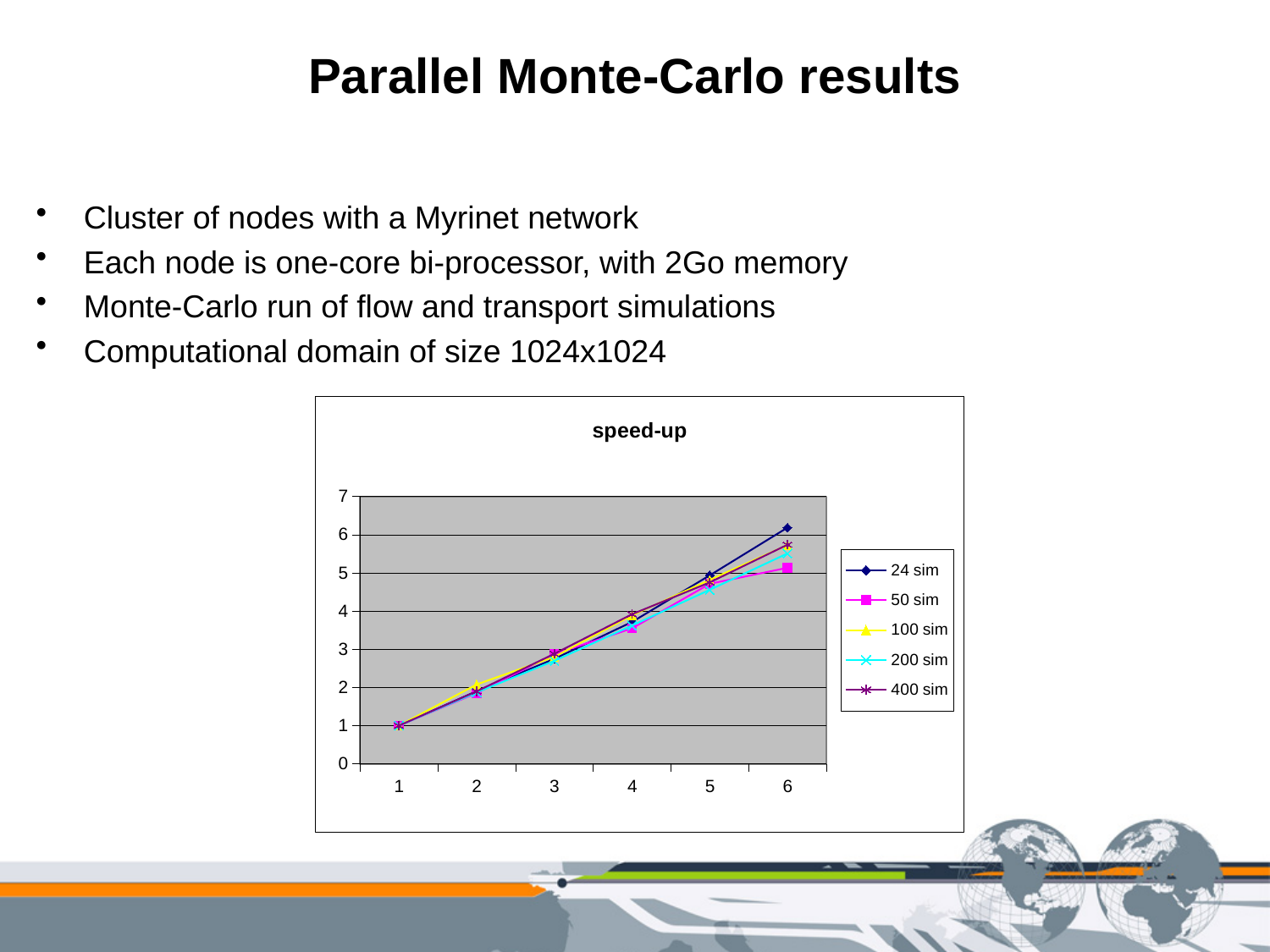
What is the speed-up value of the 24 sim series at x = 1? 1 Which series has the highest speed-up at x = 6? 24 sim Do the speed-up values rise or fall as the x axis goes from 1 to 6? rise What is the title of the chart? speed-up What kind of chart is shown on the slide? line chart Is the value for 400 sim at x = 6 greater or less than 5? greater At x = 6, which series has the larger speed-up, 24 sim or 50 sim? 24 sim Which series has the lowest speed-up at x = 6? 50 sim Is the value for 50 sim at x = 6 greater or less than 6? less How many series does the chart legend list? 5 How many points are plotted along the x axis for each series? 6 Is the value for 24 sim at x = 6 greater or less than 6? greater